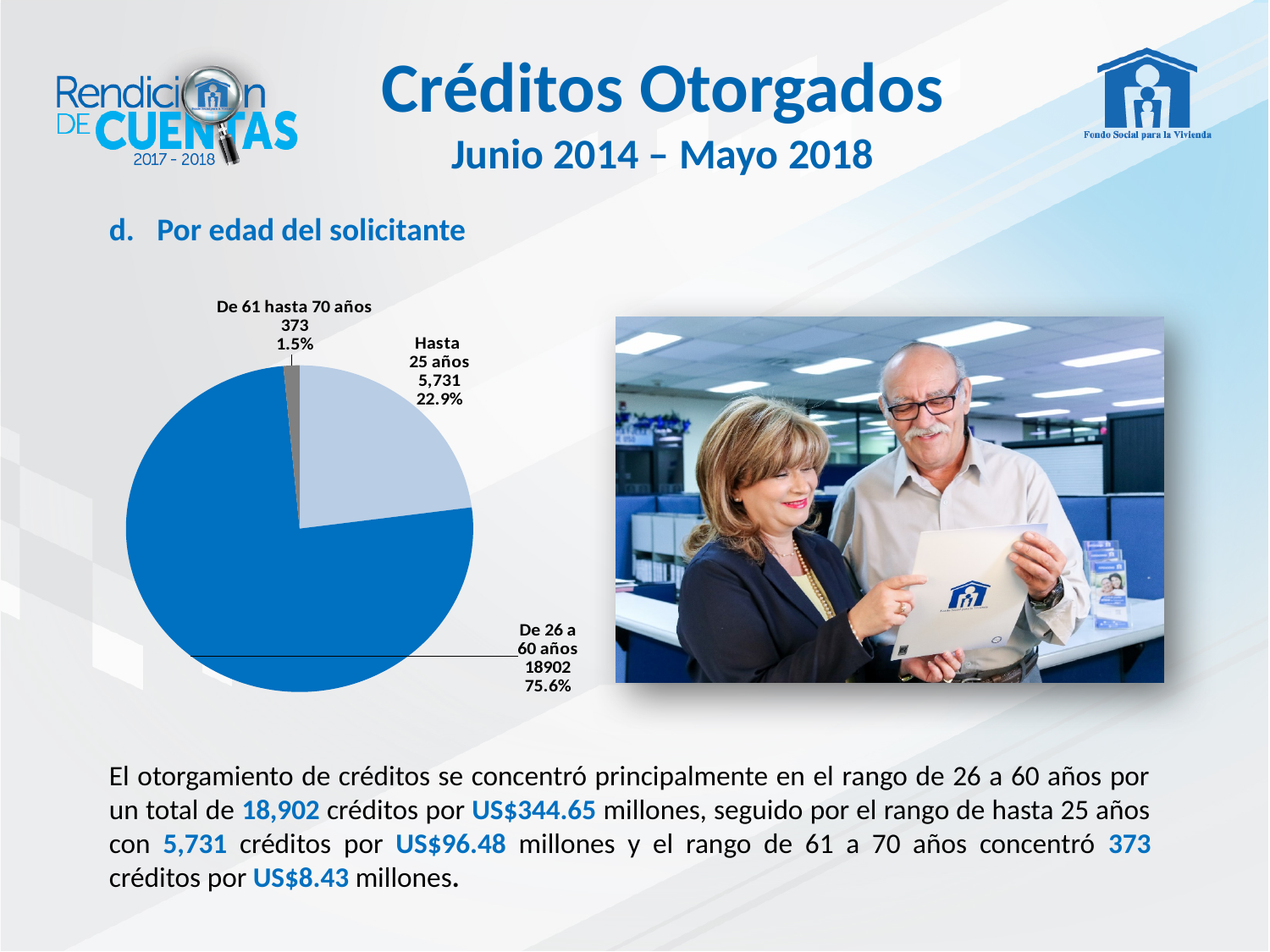
Which has more credits: 'Hasta 25 años' or 'De 61 hasta 70 años'? Hasta 25 años How many credits does the 'De 61 hasta 70 años' slice show? 373 What type of chart is shown on the slide? pie chart What share of the pie does the 'De 61 hasta 70 años' slice represent? 1.5% What is the total number of credits across all three slices of the pie? 25,006 What is the percentage shown for the 'De 26 a 60 años' slice? 75.6% What is the difference in number of credits between 'De 26 a 60 años' and 'Hasta 25 años'? 13,171 What percentage of the pie does the 'Hasta 25 años' slice represent? 22.9% Which age range has the largest slice of the pie? De 26 a 60 años How many credits were granted to applicants in the 'De 26 a 60 años' range? 18902 How many slices does the pie chart have? 3 Which age range has the smallest slice of the pie? De 61 hasta 70 años